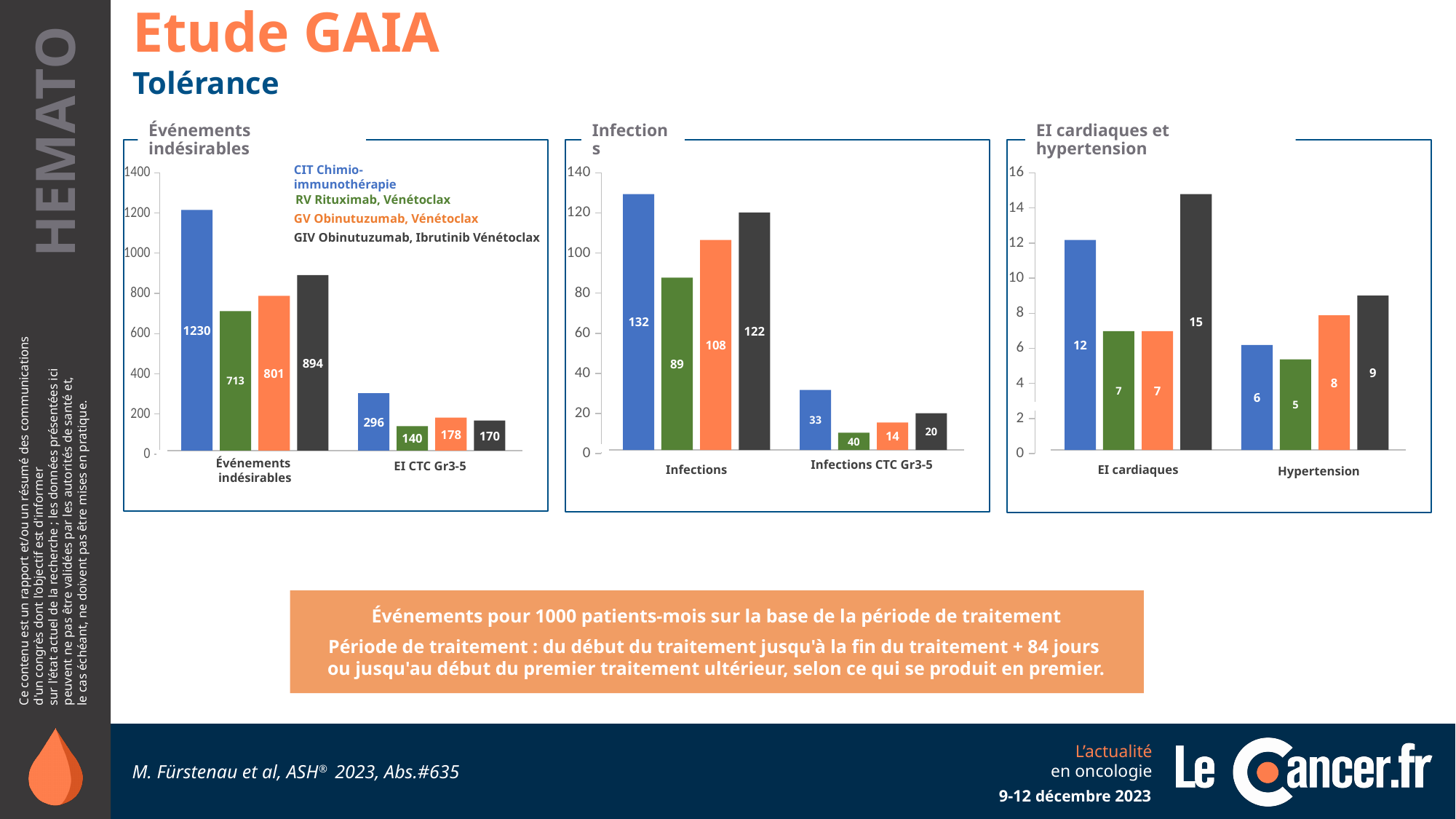
In the 'Événements indésirables' chart, what is the value for CIT (Chimio-immunothérapie) for Événements indésirables? 1230 In the 'Événements indésirables' chart, which treatment has the lowest value for EI CTC Gr3-5? RV Rituximab, Vénétoclax In the 'Infections' chart, which treatment has the highest value for Infections? CIT Chimio-immunothérapie In the 'Infections' chart, what is the value for GV (Obinutuzumab, Vénétoclax) for Infections? 108 In the 'EI cardiaques et hypertension' chart, what is the value for GIV for EI cardiaques? 15 In the 'EI cardiaques et hypertension' chart, which treatment has the lowest value for Hypertension? RV Rituximab, Vénétoclax How many treatment series does the legend list? 4 What type of chart is the 'Infections' chart? Bar chart In the 'EI cardiaques et hypertension' chart, which is larger for Hypertension: the value for CIT or the value for GV? GV In the 'Événements indésirables' chart, what is the value for GIV (Obinutuzumab, Ibrutinib Vénétoclax) for EI CTC Gr3-5? 170 In the 'Événements indésirables' chart, what is the difference between the CIT and RV values for Événements indésirables? 517 In the 'Infections' chart, is the value for GIV for Infections greater or less than 100? greater